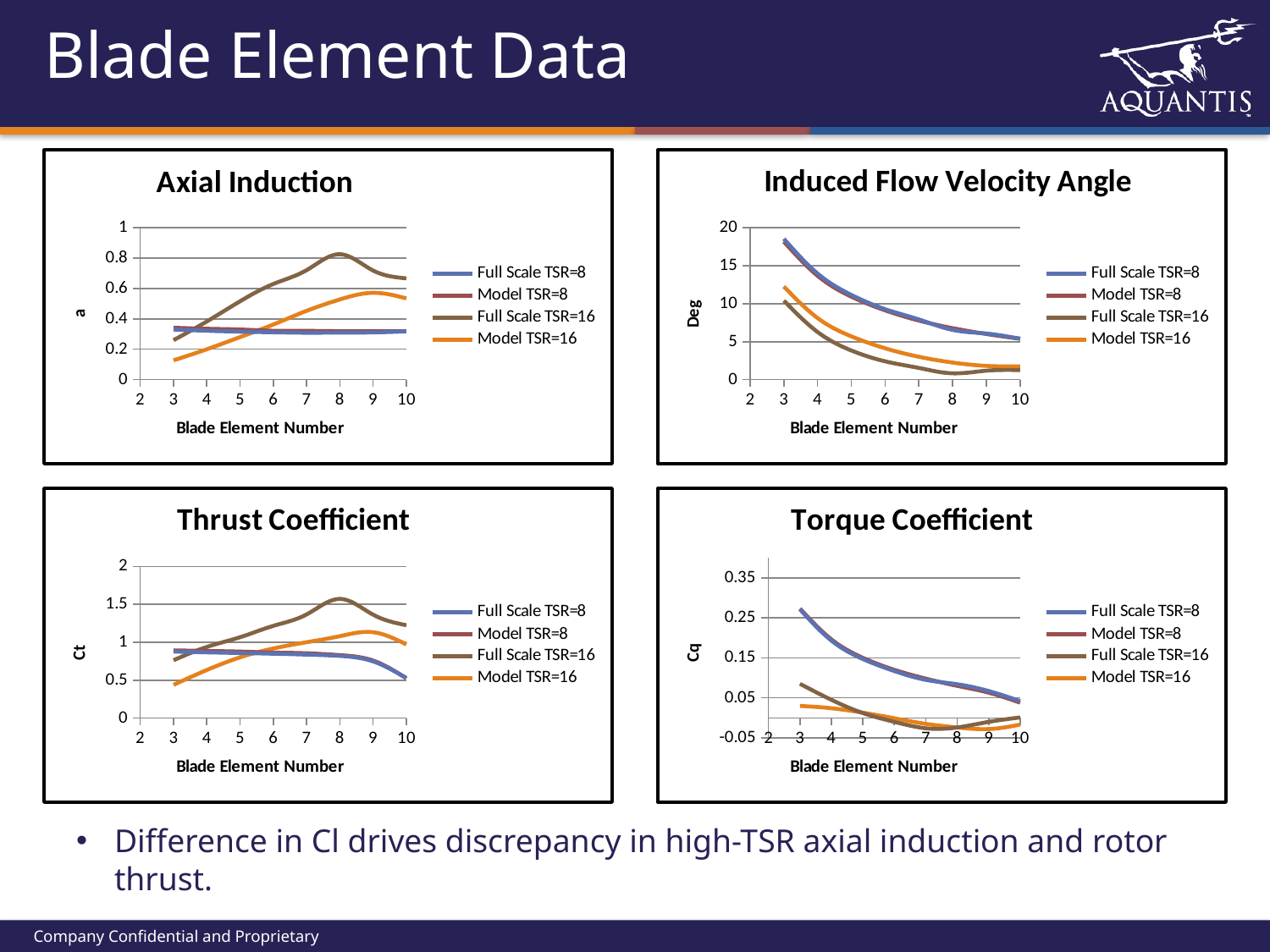
In the Torque Coefficient chart, does the Full Scale TSR=8 series rise or fall as the blade element number increases? fall In the Thrust Coefficient chart, is the value for Full Scale TSR=16 at blade element 8 greater or less than 1? greater What is the y-axis title of the Torque Coefficient chart? Cq How many series does the legend of the Axial Induction chart list? 4 In the Torque Coefficient chart, is the value for Full Scale TSR=8 at blade element 3 greater or less than 0.15? greater In the Induced Flow Velocity Angle chart, which series is higher at blade element 3, Full Scale TSR=8 or Model TSR=16? Full Scale TSR=8 In the Induced Flow Velocity Angle chart, is the value for Full Scale TSR=16 at blade element 8 greater or less than 5? less In the Induced Flow Velocity Angle chart, does the Full Scale TSR=8 series rise or fall as the blade element number increases? fall What kind of chart is the Axial Induction chart? line chart What is the x-axis title of the Axial Induction chart? Blade Element Number